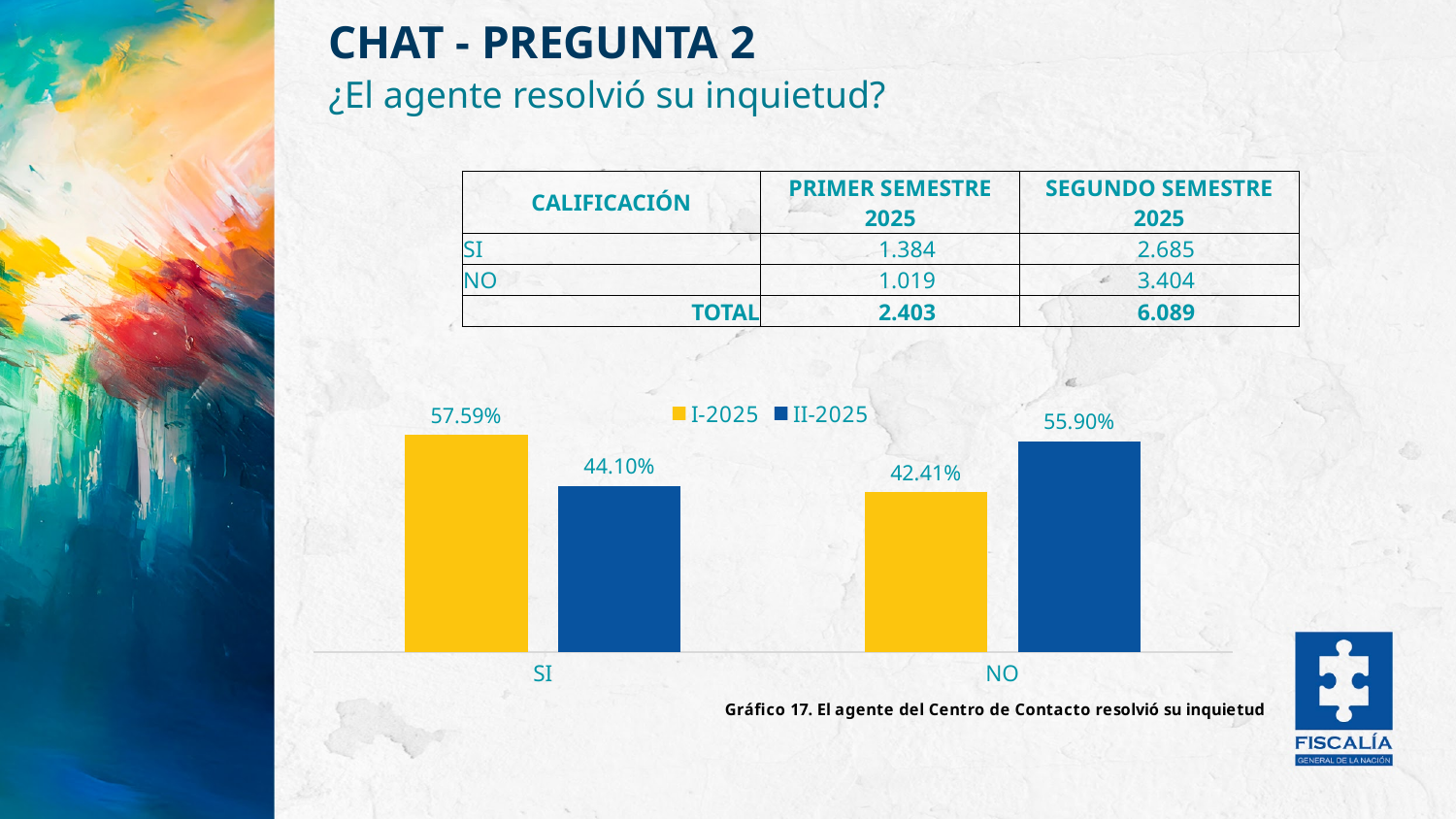
What is the value for SI in the II-2025 series? 44.10% What is the value for SI in the I-2025 series? 57.59% What is the value for NO in the II-2025 series? 55.90% What is the value for NO in the I-2025 series? 42.41% What kind of chart is shown on the slide? Bar chart How many series does the chart legend list? 2 Which category has the lowest value in the II-2025 series? SI For the NO category, which series has the larger value, I-2025 or II-2025? II-2025 What is the difference between the II-2025 and I-2025 values for NO? 13.49% What is the difference between the I-2025 and II-2025 values for SI? 13.49% How many categories are shown on the x axis of the chart? 2 Which category has the highest value in the I-2025 series? SI